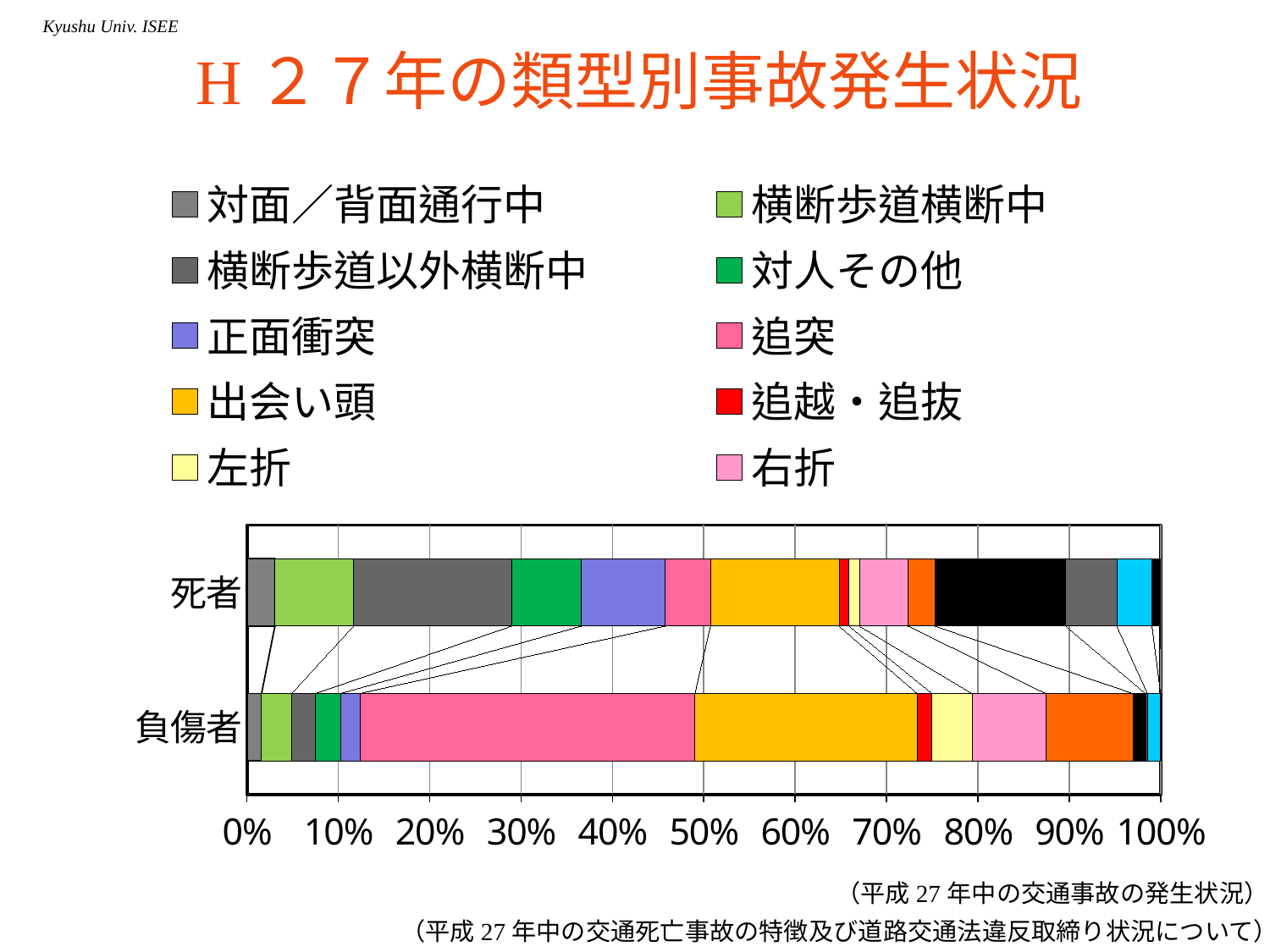
Is the share of 横断歩道以外横断中 larger in the 死者 bar or in the 負傷者 bar? 死者 What are the two categories shown on the vertical axis of the chart? 死者 and 負傷者 How many series does the legend list? 10 What kind of chart is shown on the slide? Stacked bar chart Is the share of 追突 larger in the 死者 bar or in the 負傷者 bar? 負傷者 Is the share of 追突 in the 負傷者 bar greater or less than 30%? greater Is the share of 出会い頭 in the 負傷者 bar greater or less than 20%? greater Which legend series occupies the largest share of the 負傷者 bar? 追突 Is the share of 横断歩道以外横断中 in the 死者 bar greater or less than 10%? greater How many categories (bars) does the chart show? 2 What is the title of the slide containing the chart? Ｈ２７年の類型別事故発生状況